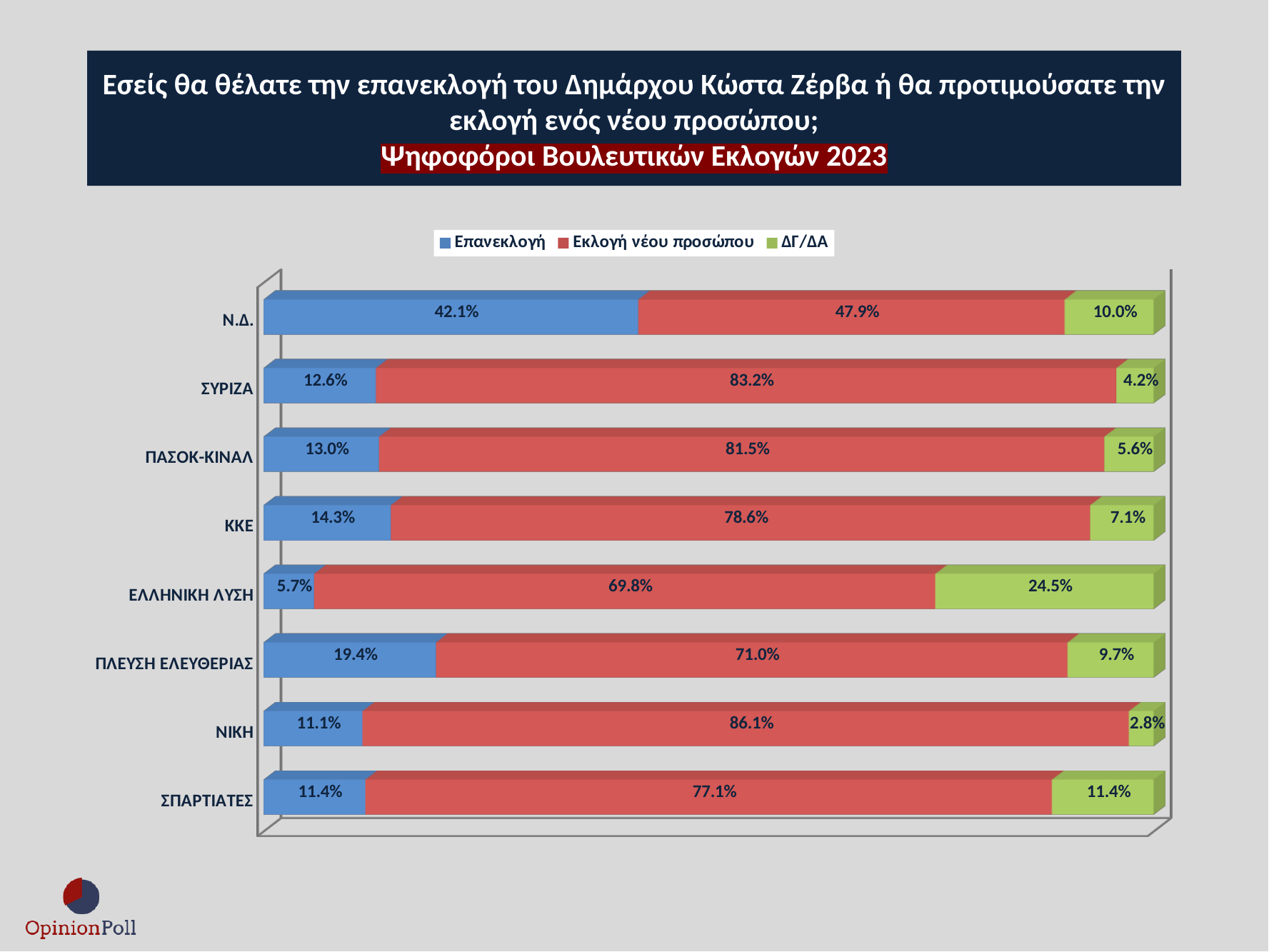
Which category has the lowest Επανεκλογή value? ΕΛΛΗΝΙΚΗ ΛΥΣΗ What is the difference between the Εκλογή νέου προσώπου and Επανεκλογή values for Ν.Δ.? 5.8% Which category has the lowest ΔΓ/ΔΑ value? ΝΙΚΗ Which is larger: the Επανεκλογή value for ΠΛΕΥΣΗ ΕΛΕΥΘΕΡΙΑΣ or for ΚΚΕ? ΠΛΕΥΣΗ ΕΛΕΥΘΕΡΙΑΣ How many categories are shown on the chart? 8 How many series does the legend list? 3 What is the Εκλογή νέου προσώπου value for ΝΙΚΗ? 86.1% What is the ΔΓ/ΔΑ value for ΕΛΛΗΝΙΚΗ ΛΥΣΗ? 24.5% What is the total of the stacked bar for ΣΠΑΡΤΙΑΤΕΣ? 99.9% Which category has the highest Επανεκλογή value? Ν.Δ. What is the Επανεκλογή value for Ν.Δ.? 42.1% What kind of chart is shown on the slide? Stacked bar chart